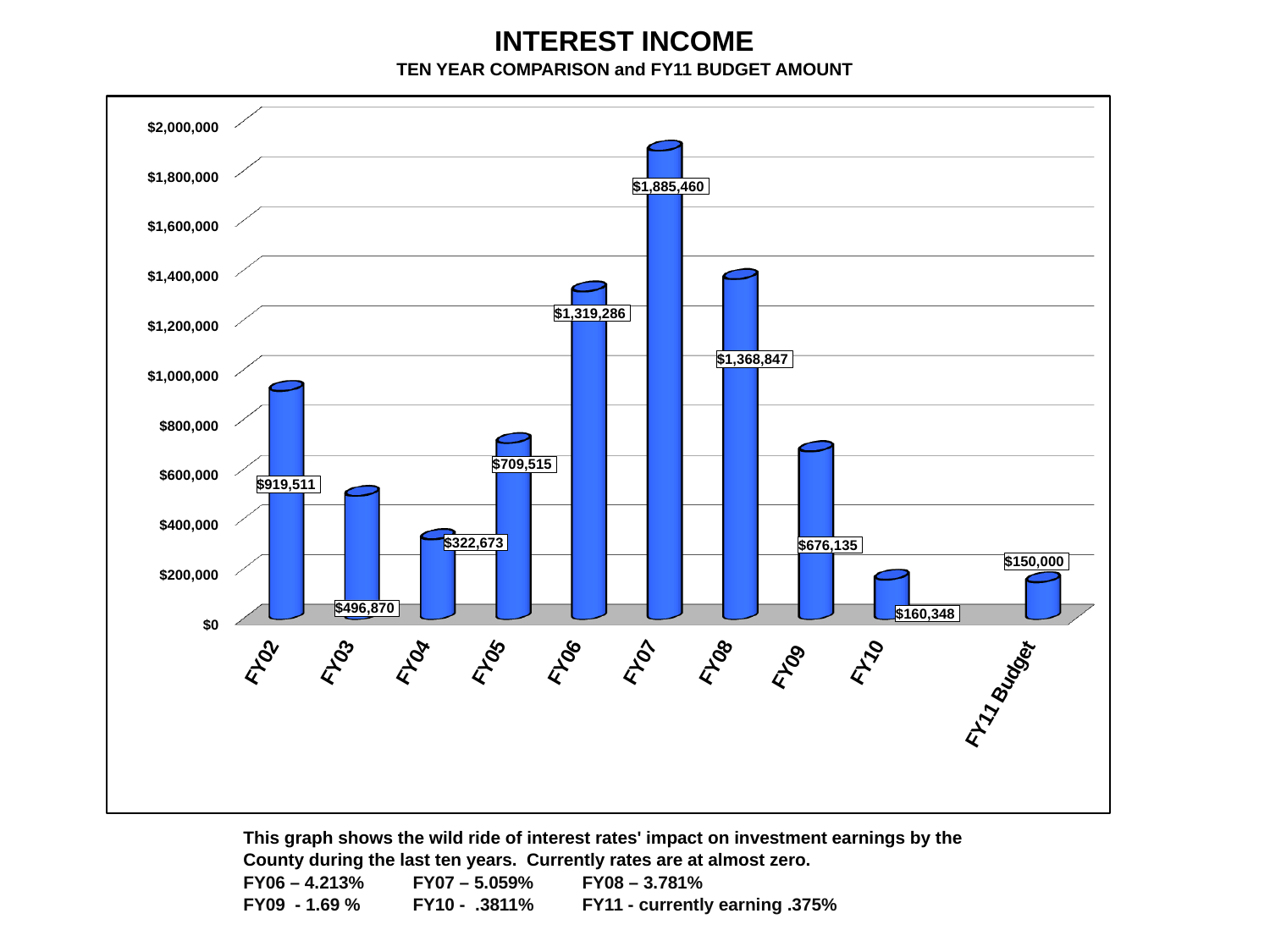
What is the FY11 Budget amount shown on the chart? $150,000 Which fiscal year has the highest interest income? FY07 What kind of chart is shown on the slide? bar chart What is the difference between the FY02 and FY03 interest income values? $422,641 How many categories are shown on the x axis? 10 What is the interest income value for FY03? $496,870 Do the values rise or fall from FY07 to FY10? fall What is the interest income value for FY07? $1,885,460 Which category has the lowest value on the chart? FY11 Budget Which is larger, the interest income for FY06 or for FY08? FY08 What is the difference between the FY07 and FY06 interest income values? $566,174 Is the value for FY09 greater or less than $800,000? less